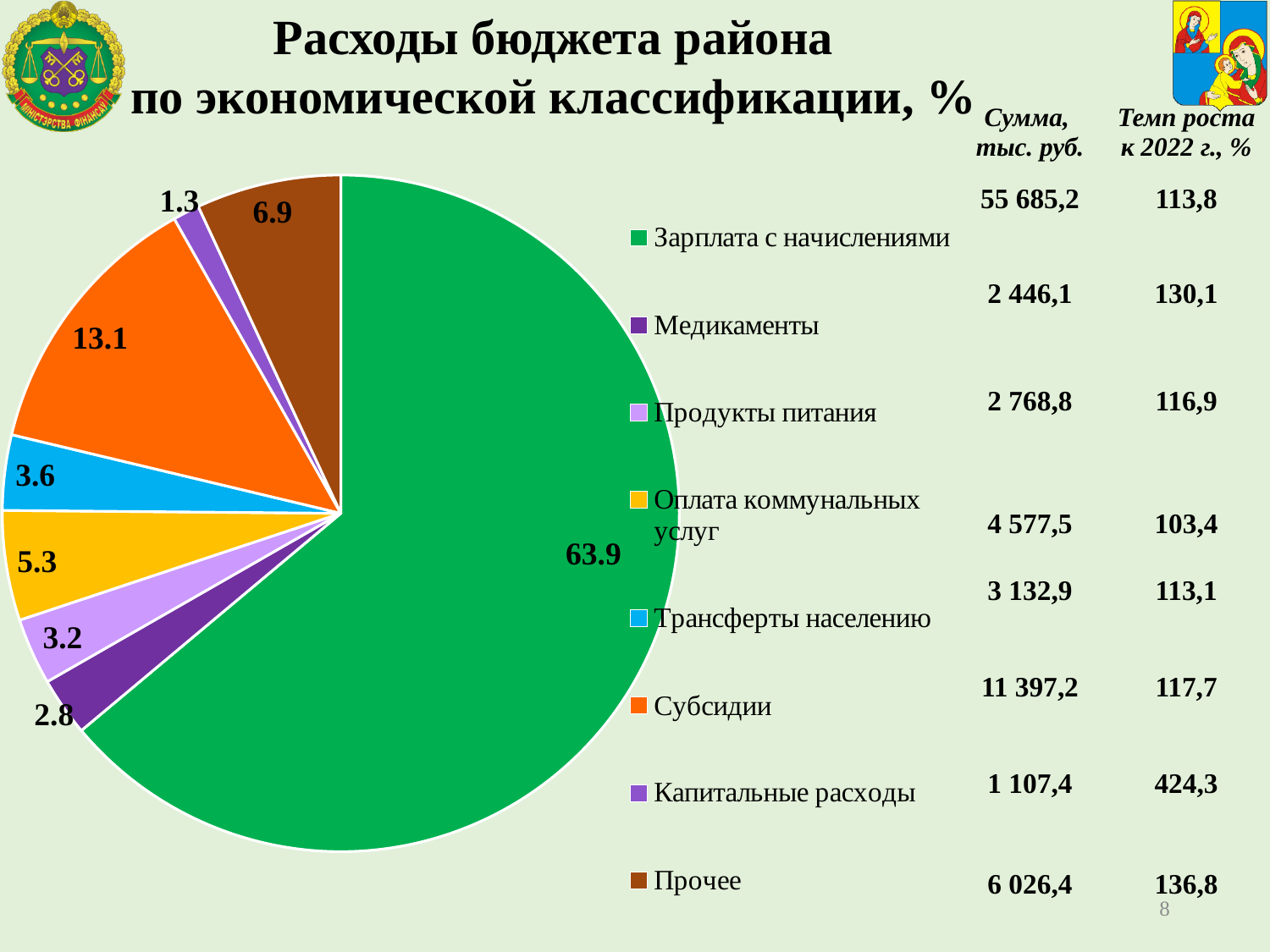
What kind of chart is shown on the slide? pie chart What is the value shown for Капитальные расходы in the pie chart? 1.3 Which category has the largest slice in the pie chart? Зарплата с начислениями How many categories does the legend of the pie chart list? 8 What is the value shown for Медикаменты in the pie chart? 2.8 What colour is the slice for Прочее in the pie chart? brown What is the value shown for Зарплата с начислениями in the pie chart? 63.9 Which category has the smallest slice in the pie chart? Капитальные расходы Which is larger in the pie chart, Трансферты населению or Продукты питания? Трансферты населению What is the value shown for Субсидии in the pie chart? 13.1 What is the difference between the values for Субсидии and Прочее in the pie chart? 6.2 What is the value shown for Оплата коммунальных услуг in the pie chart? 5.3